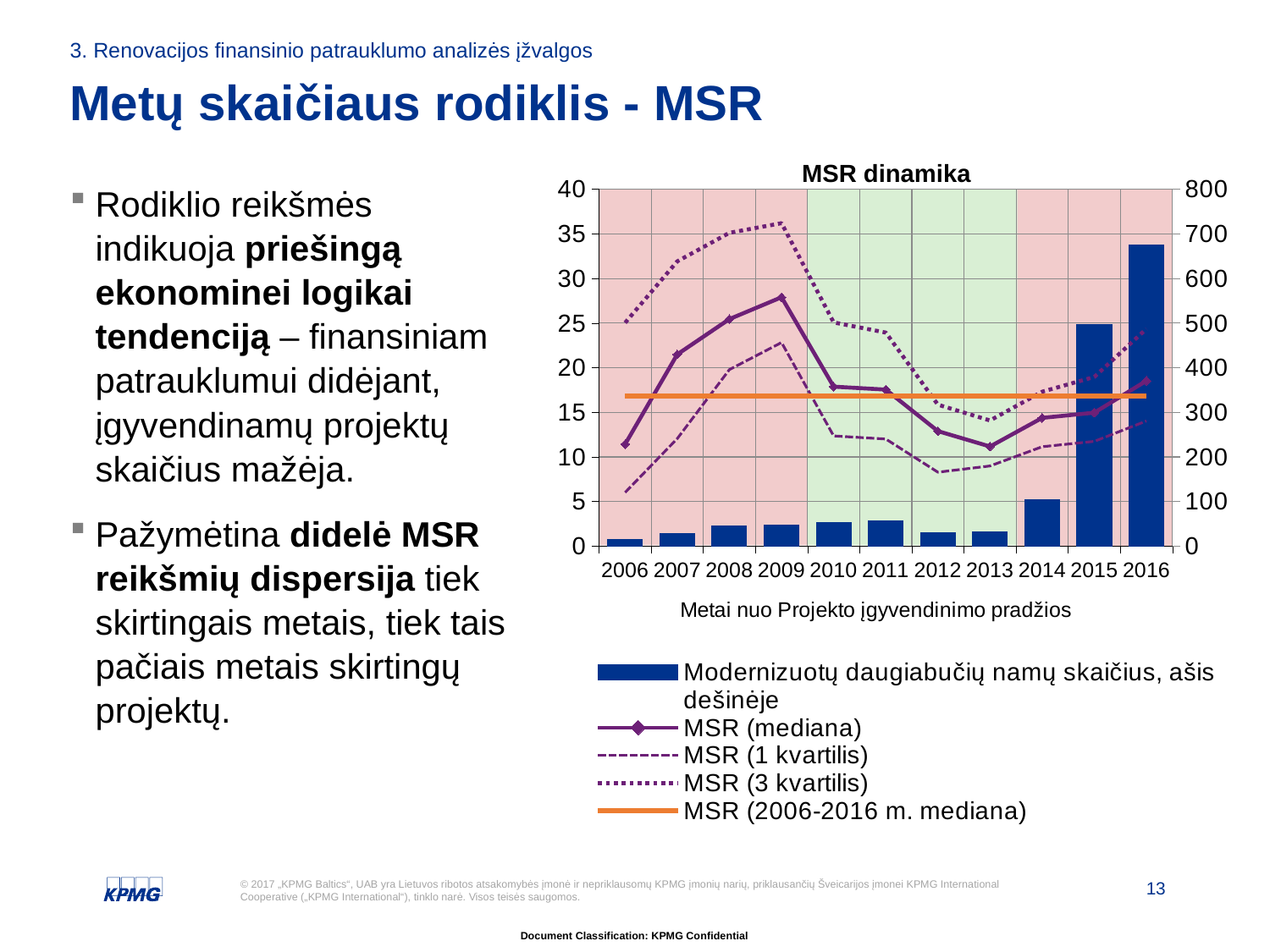
How many series does the legend of the "MSR dinamika" chart list? 5 Is the bar for "Modernizuotų daugiabučių namų skaičius" in 2016 greater or less than 600 on the right axis? greater How many years are shown on the x axis of the "MSR dinamika" chart? 11 In which year is the bar for "Modernizuotų daugiabučių namų skaičius" the highest? 2016 What kind of chart is shown under the title "MSR dinamika"? A combination chart of bars and lines Do the bars for "Modernizuotų daugiabučių namų skaičius" rise or fall from 2013 to 2016? rise Which year has the larger bar for "Modernizuotų daugiabučių namų skaičius", 2015 or 2016? 2016 In which year does the "MSR (mediana)" line reach its highest value? 2009 In which year does the "MSR (mediana)" line reach its lowest value? 2013 Is the "MSR (mediana)" value for 2009 greater or less than 25? greater Is the "MSR (mediana)" value for 2013 greater or less than 15? less In which year is the bar for "Modernizuotų daugiabučių namų skaičius" the lowest? 2006